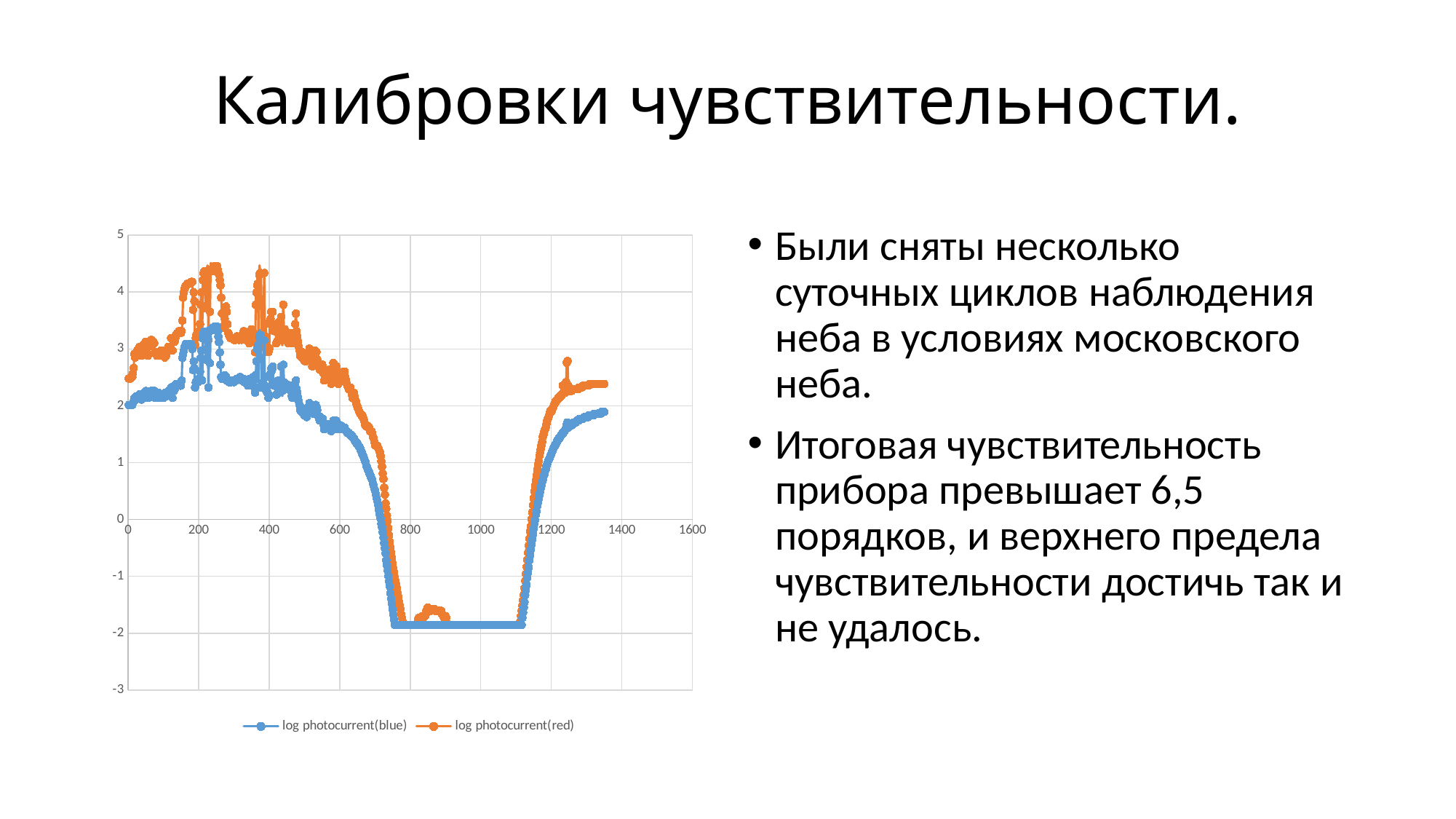
Around x = 1300, which series has the higher value, log photocurrent(blue) or log photocurrent(red)? log photocurrent(red) How many series does the legend list? 2 Is the value of log photocurrent(blue) at x = 1000 greater or less than -1? less Is the value of log photocurrent(red) at x = 1300 greater or less than 2? greater Is the value of log photocurrent(blue) at x = 600 greater or less than 1? greater What are the names of the two series in the legend? log photocurrent(blue) and log photocurrent(red) What kind of chart is shown on the slide? line chart Do the values of log photocurrent(blue) rise or fall between x = 600 and x = 800? fall Do the values of log photocurrent(red) rise or fall between x = 1100 and x = 1200? rise Around x = 200, which series has the higher value, log photocurrent(blue) or log photocurrent(red)? log photocurrent(red) Which colour is used for the series log photocurrent(red)? orange